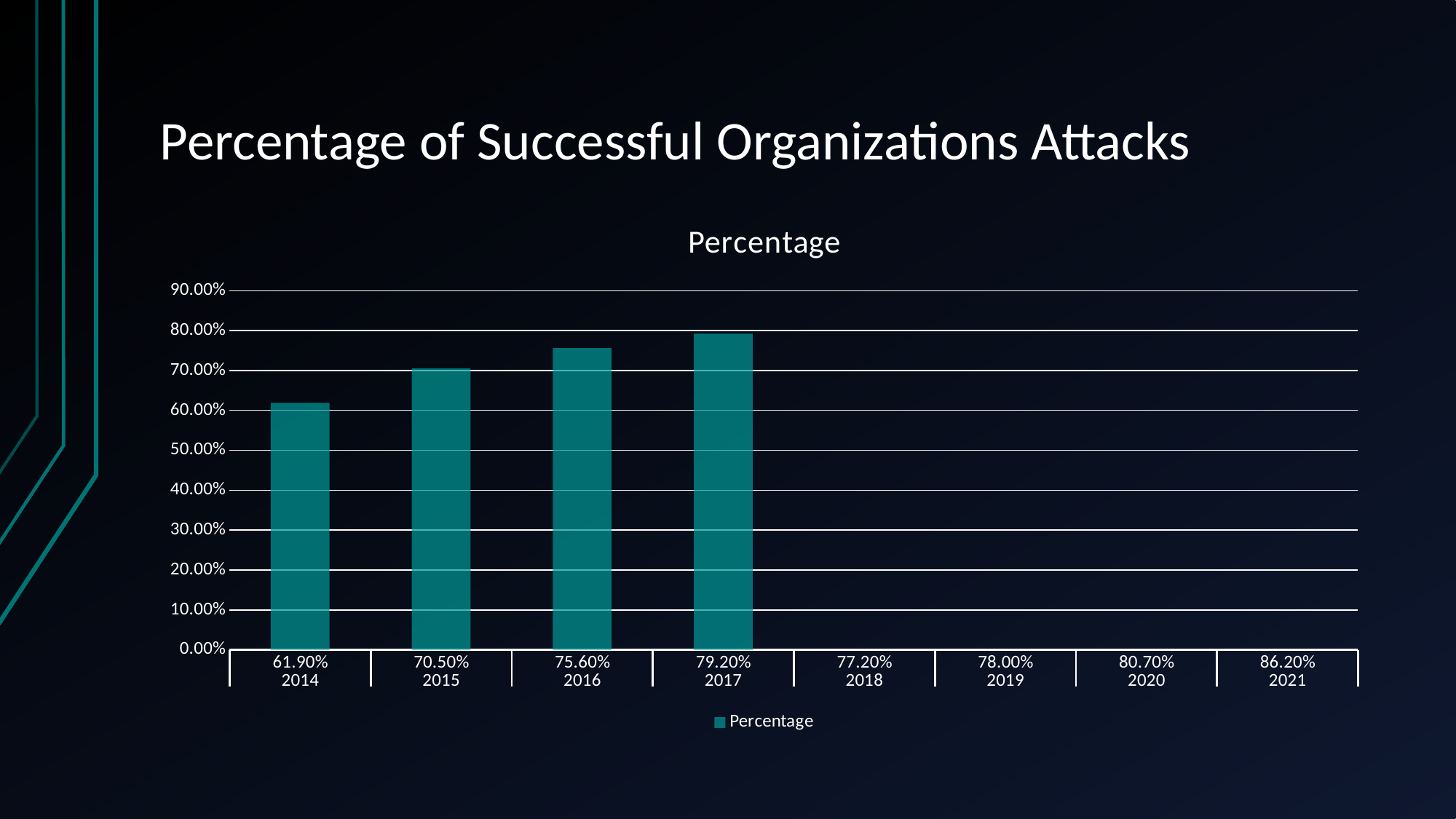
What is the percentage value shown for 2016? 75.60% What is the difference between the values for 2017 and 2014? 17.30% Is the bar for 2017 greater or less than 80.00%? less Do the drawn bars rise or fall from 2014 to 2017? rise Which year among the drawn bars has the highest value? 2017 How many series does the legend list? 1 What type of chart is shown on the slide? bar chart Which is larger, the value for 2016 or the value for 2015? 2016 Which year among the drawn bars has the lowest value? 2014 What is the percentage value shown for 2017? 79.20% What is the percentage value shown for 2014? 61.90% How many bars are drawn on the chart? 4